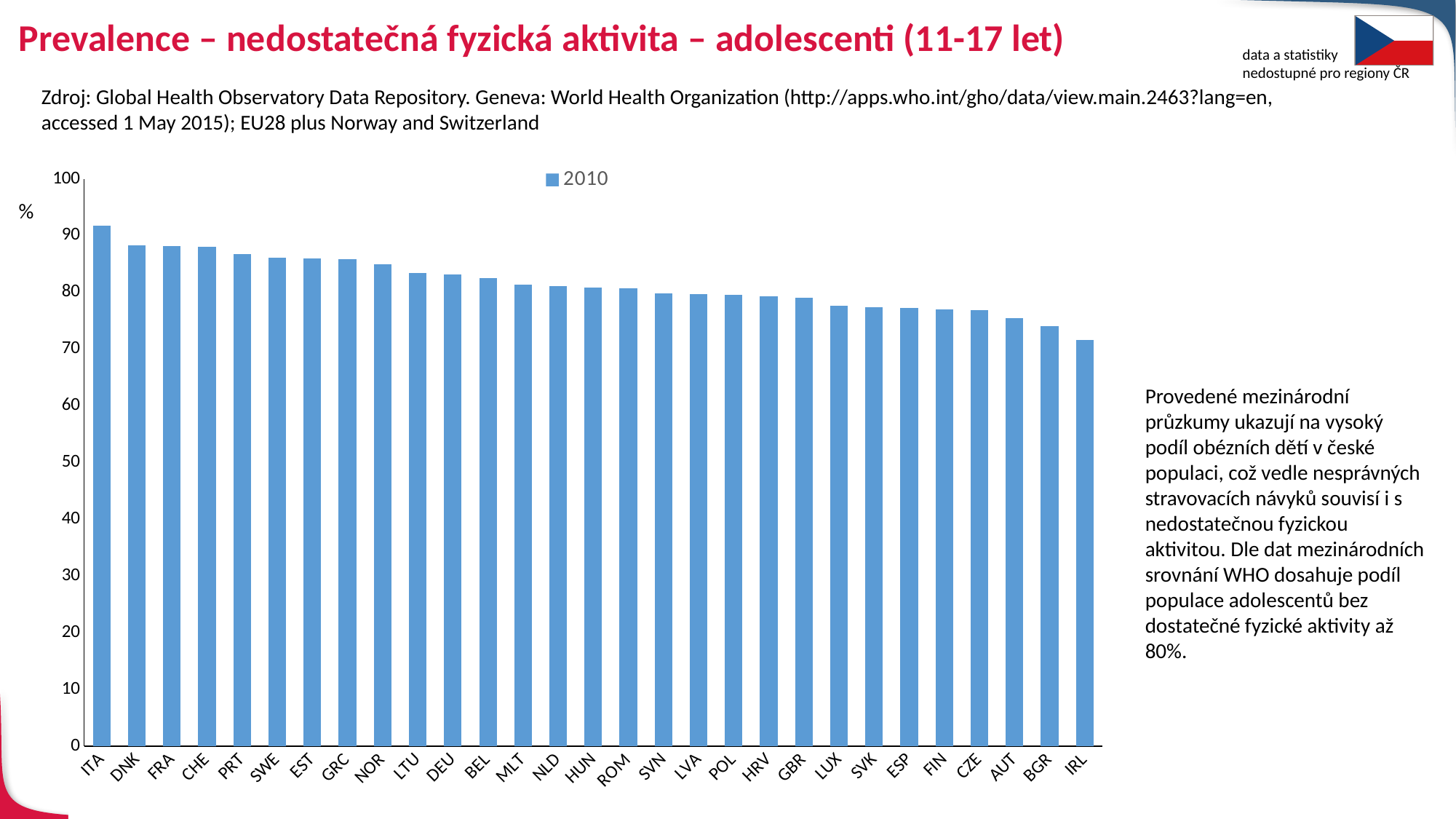
Which has the larger value, ITA or IRL? ITA Which year does the legend entry of the chart refer to? 2010 Is the value for BGR greater or less than 80? less How many countries are shown on the x axis of the chart? 29 Which has the larger value, NOR or AUT? NOR Do the values rise or fall from left to right along the x axis? fall Is the value for DNK greater or less than 80? greater What kind of chart is shown on the slide? bar chart Which country has the highest value in the chart? ITA Which country has the lowest value in the chart? IRL Is the value for IRL greater or less than 80? less How many series does the chart legend list? 1